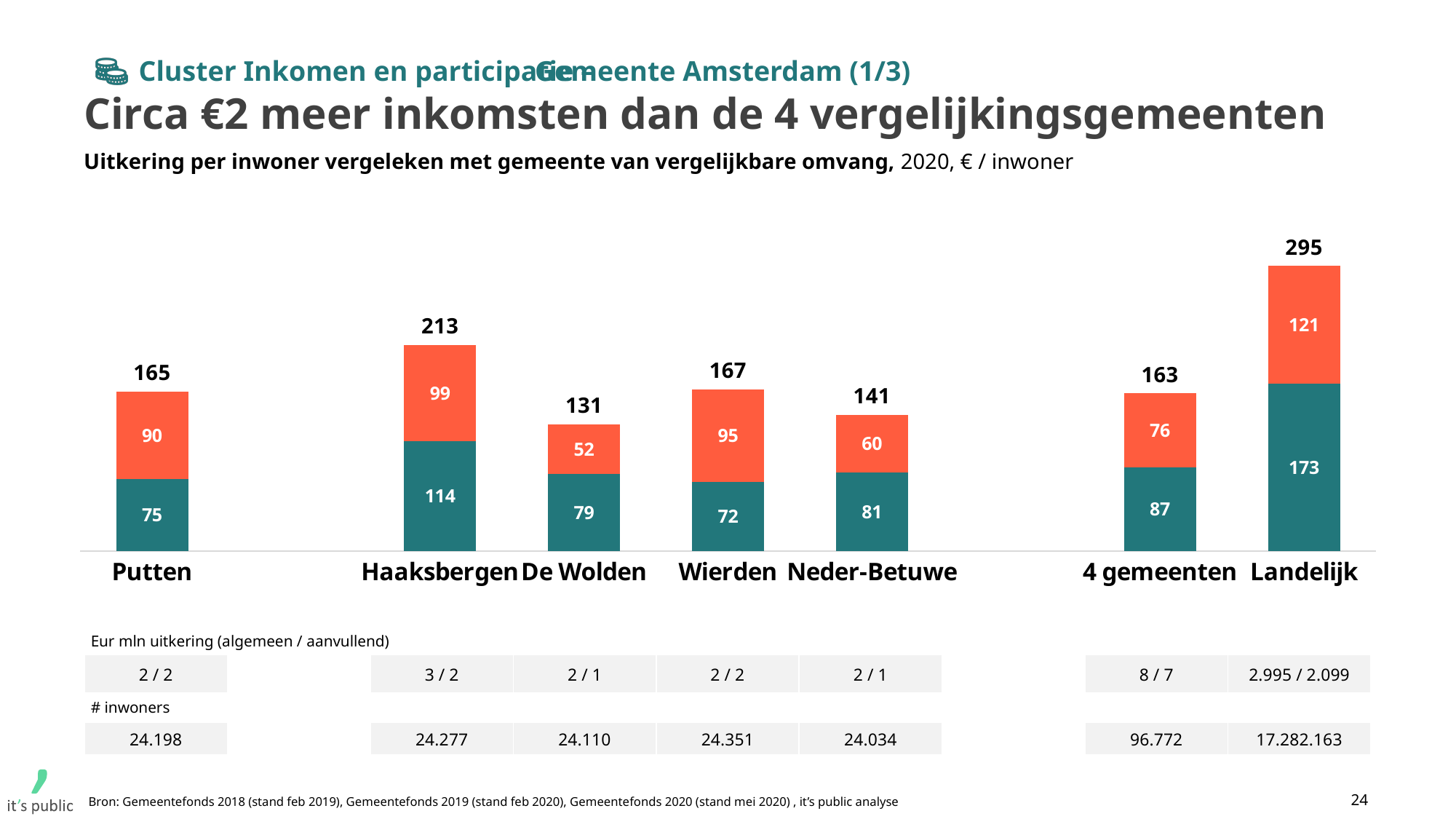
Which has a larger total value, Putten or Neder-Betuwe? Putten What is the sum of the teal and orange segments for De Wolden? 131 Which category has the lowest total value? De Wolden What is the total value shown above the bar for Haaksbergen? 213 How many categories are shown on the x axis of the chart? 7 What is the value of the teal (bottom) segment of the bar for Landelijk? 173 What is the difference between the orange segment and the teal segment for Putten? 15 Which category has the highest total value? Landelijk What kind of chart is shown on the slide? Stacked bar chart What is the difference between the total for Landelijk and the total for 4 gemeenten? 132 What is the value of the orange (top) segment of the bar for Wierden? 95 Which category has the largest orange (top) segment? Landelijk